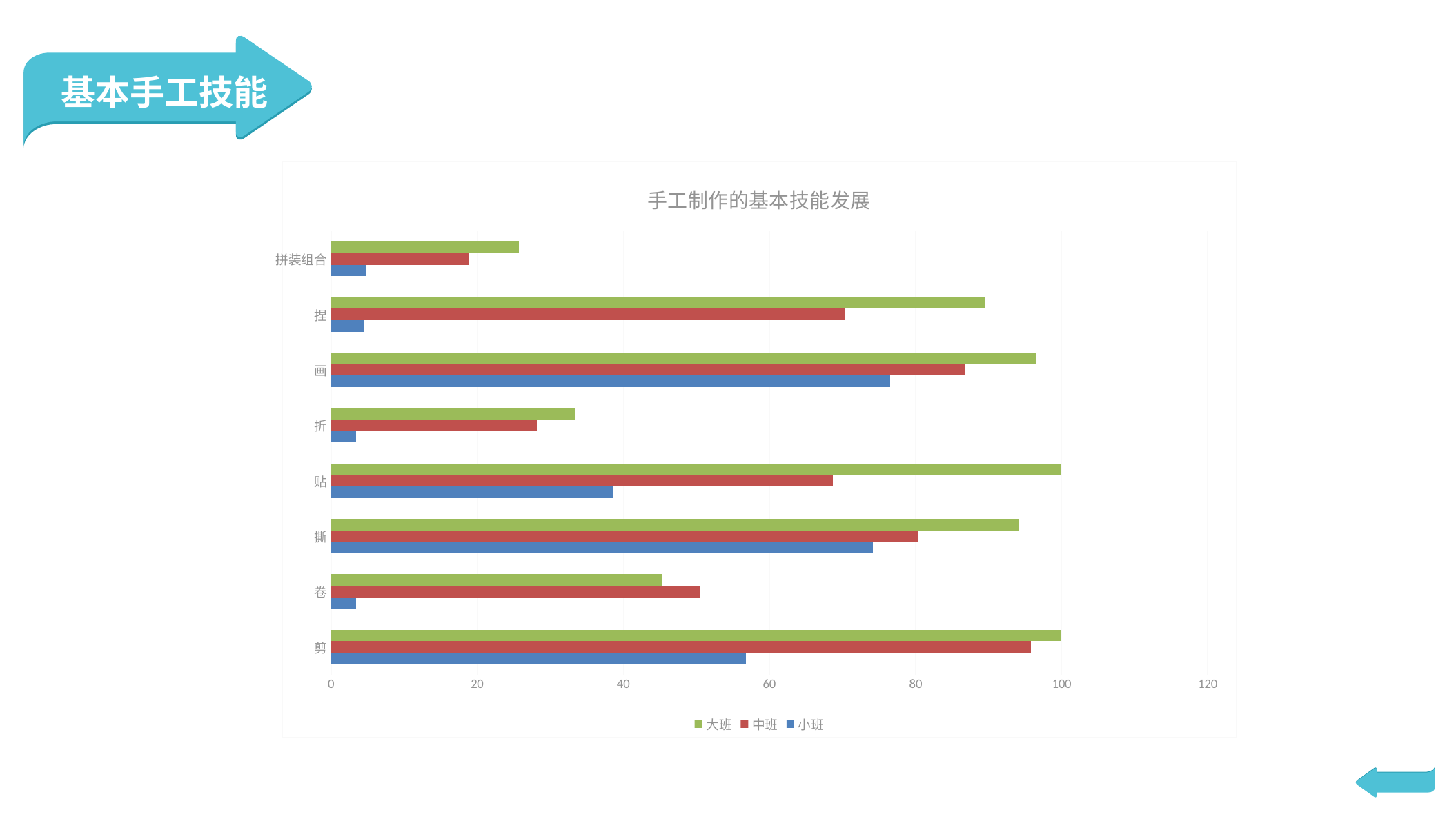
In the 捏 category, which series has the larger value, 大班 or 小班? 大班 Which category has the lowest value for the 大班 series? 拼装组合 What kind of chart is shown on the slide? bar chart How many series does the legend list? 3 Is the value for 中班 in the 剪 category greater or less than 80? greater For the 中班 series, which value is larger, 卷 or 折? 卷 Is the value for 中班 in the 折 category greater or less than 40? less How many categories are shown on the vertical axis of the chart? 8 What is the title of the chart? 手工制作的基本技能发展 Which category has the highest value for the 中班 series? 剪 Is the value for 小班 in the 画 category greater or less than 60? greater What is the value for 大班 in the 剪 category? 100